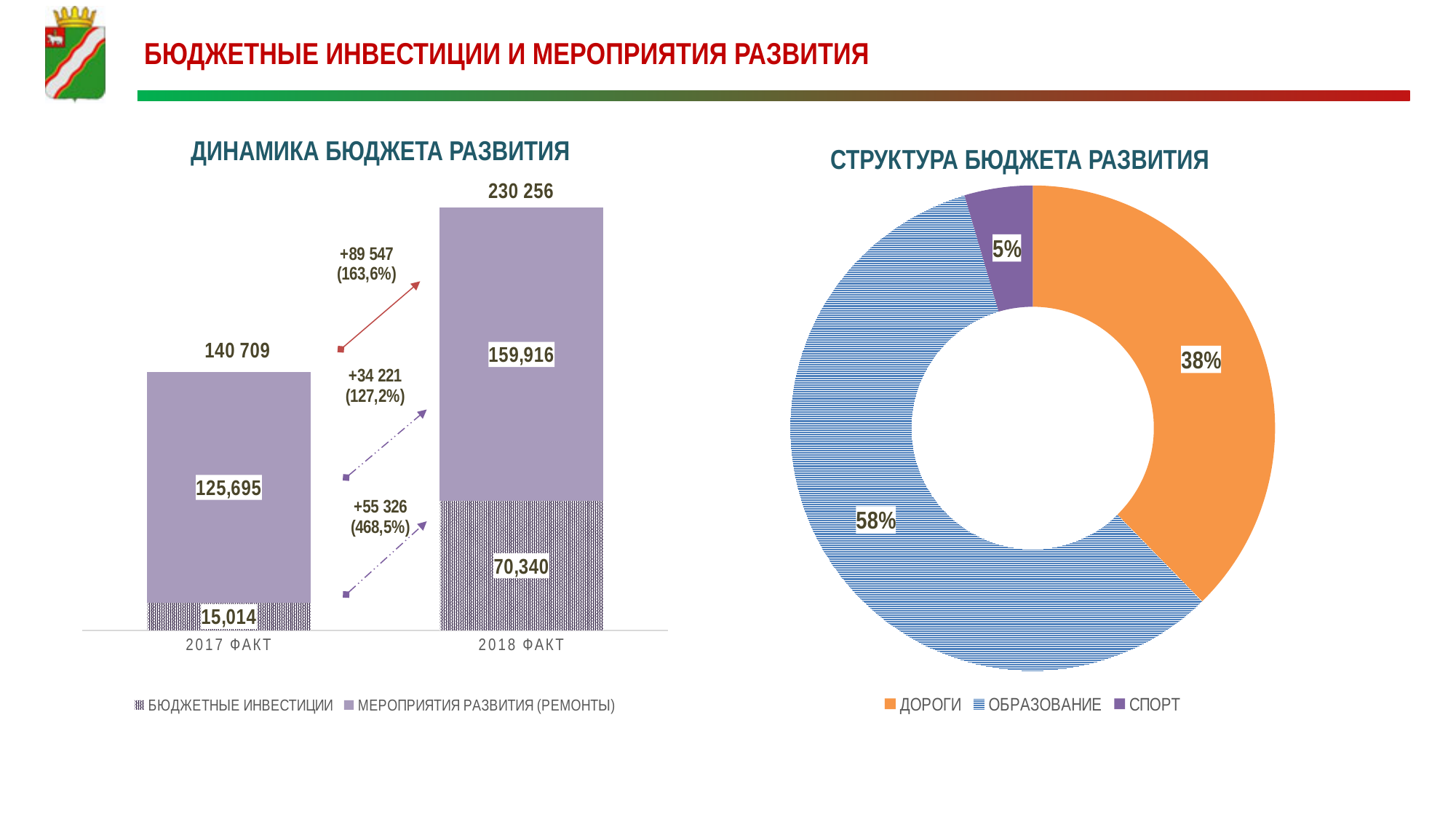
In the chart titled "ДИНАМИКА БЮДЖЕТА РАЗВИТИЯ", how many series does the legend list? 2 In the chart titled "ДИНАМИКА БЮДЖЕТА РАЗВИТИЯ", which is larger: БЮДЖЕТНЫЕ ИНВЕСТИЦИИ in 2017 ФАКТ or in 2018 ФАКТ? 2018 ФАКТ In the chart titled "СТРУКТУРА БЮДЖЕТА РАЗВИТИЯ", what share does ОБРАЗОВАНИЕ have? 58% In the chart titled "СТРУКТУРА БЮДЖЕТА РАЗВИТИЯ", which category has the smallest share? СПОРТ What kind of chart is the one titled "ДИНАМИКА БЮДЖЕТА РАЗВИТИЯ"? stacked bar chart In the chart titled "ДИНАМИКА БЮДЖЕТА РАЗВИТИЯ", what is the total of the stacked bar for 2018 ФАКТ? 230 256 In the chart titled "ДИНАМИКА БЮДЖЕТА РАЗВИТИЯ", what is the value of БЮДЖЕТНЫЕ ИНВЕСТИЦИИ for 2017 ФАКТ? 15,014 In the chart titled "ДИНАМИКА БЮДЖЕТА РАЗВИТИЯ", does the total budget rise or fall from 2017 ФАКТ to 2018 ФАКТ? rise In the chart titled "ДИНАМИКА БЮДЖЕТА РАЗВИТИЯ", what is the value of МЕРОПРИЯТИЯ РАЗВИТИЯ (РЕМОНТЫ) for 2018 ФАКТ? 159,916 In the chart titled "ДИНАМИКА БЮДЖЕТА РАЗВИТИЯ", what is the total of the stacked bar for 2017 ФАКТ? 140 709 In the chart titled "СТРУКТУРА БЮДЖЕТА РАЗВИТИЯ", what colour is the ДОРОГИ slice? orange In the chart titled "СТРУКТУРА БЮДЖЕТА РАЗВИТИЯ", how many categories are shown? 3